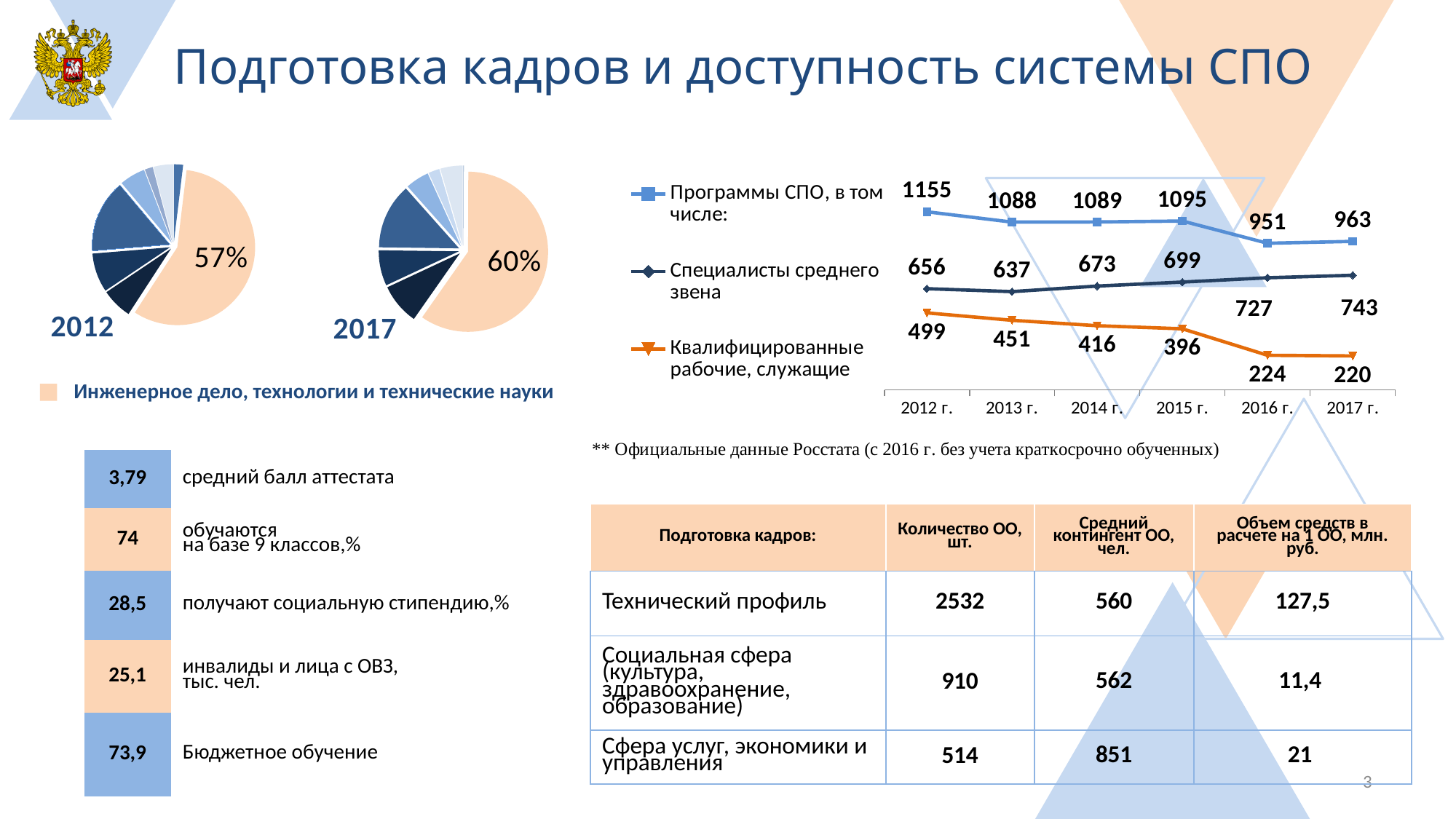
In the line chart, what is the value for Специалисты среднего звена in 2015 г.? 699 In the line chart, which is larger in 2016 г.: Специалисты среднего звена or Квалифицированные рабочие, служащие? Специалисты среднего звена In the 2017 pie chart, what share does Инженерное дело, технологии и технические науки have? 60% In the line chart, does the value for Квалифицированные рабочие, служащие rise or fall from 2012 г. to 2017 г.? fall In the line chart, what is the value for Квалифицированные рабочие, служащие in 2017 г.? 220 In the line chart, what is the value for Программы СПО in 2012 г.? 1155 How many series does the legend of the line chart list? 3 In the 2012 pie chart, what share does Инженерное дело, технологии и технические науки have? 57% How many years are shown on the x axis of the line chart? 6 In the line chart, in which year is the value for Специалисты среднего звена highest? 2017 г. In the line chart, in which year is the value for Квалифицированные рабочие, служащие lowest? 2017 г. In the line chart, what is the difference between the Программы СПО values for 2012 г. and 2017 г.? 192